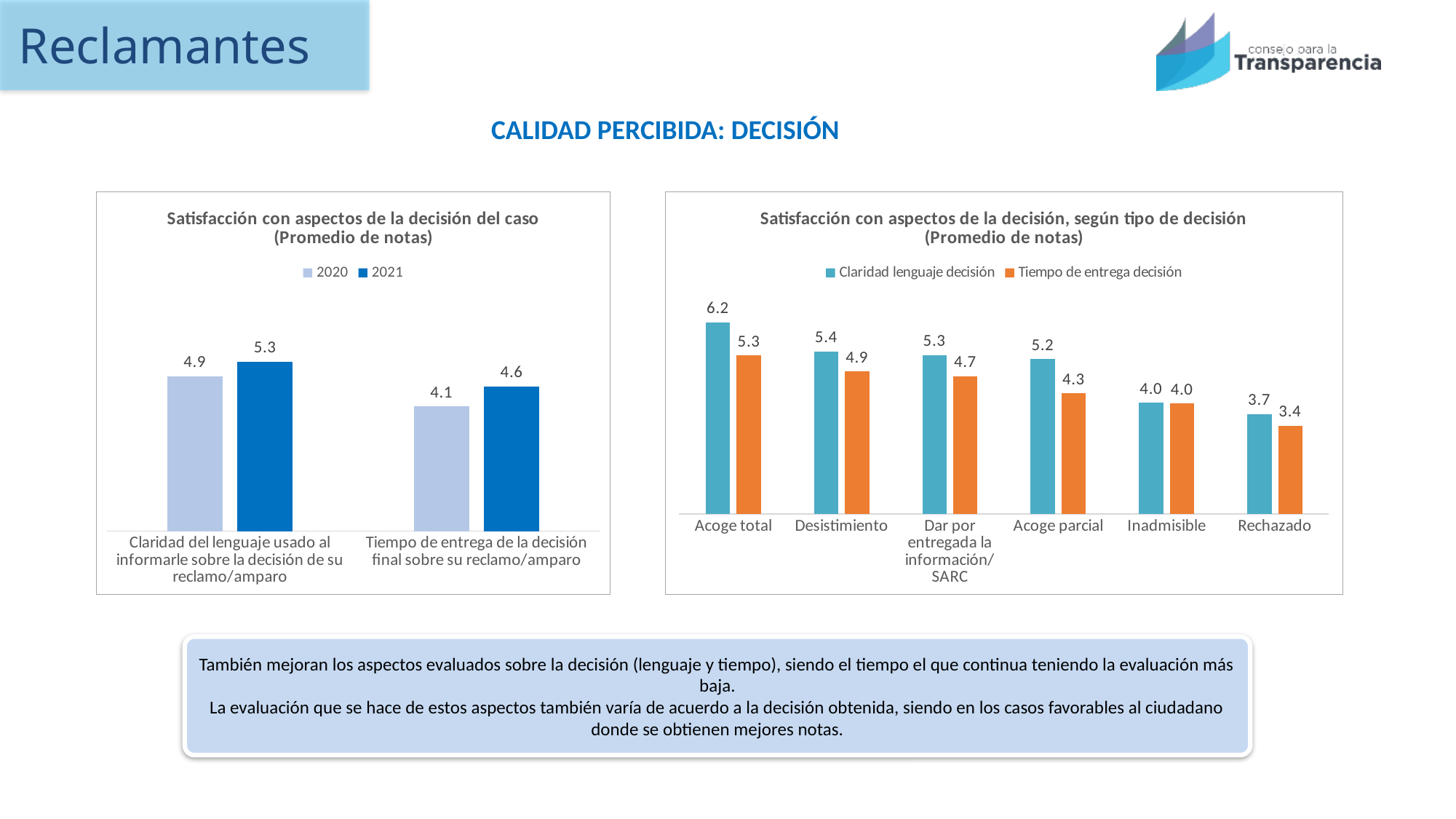
In the right chart (Satisfacción con aspectos de la decisión, según tipo de decisión), which decision type has the highest 'Claridad lenguaje decisión' value? Acoge total In the right chart (Satisfacción con aspectos de la decisión, según tipo de decisión), how many decision types are shown on the x axis? 6 In the left chart (Satisfacción con aspectos de la decisión del caso), what is the 2021 value for 'Claridad del lenguaje usado al informarle sobre la decisión de su reclamo/amparo'? 5.3 In the left chart (Satisfacción con aspectos de la decisión del caso), how many series does the legend list? 2 In the right chart (Satisfacción con aspectos de la decisión, según tipo de decisión), which decision type has the lowest 'Tiempo de entrega decisión' value? Rechazado In the left chart (Satisfacción con aspectos de la decisión del caso), by how much did the value for 'Tiempo de entrega de la decisión final sobre su reclamo/amparo' change from 2020 to 2021? 0.5 In the right chart (Satisfacción con aspectos de la decisión, según tipo de decisión), what is the 'Claridad lenguaje decisión' value for 'Acoge total'? 6.2 In the right chart (Satisfacción con aspectos de la decisión, según tipo de decisión), what is the difference between the 'Claridad lenguaje decisión' and 'Tiempo de entrega decisión' values for 'Acoge parcial'? 0.9 In the left chart (Satisfacción con aspectos de la decisión del caso), which year has the higher value for 'Claridad del lenguaje usado al informarle sobre la decisión de su reclamo/amparo'? 2021 What kind of chart is the right chart (Satisfacción con aspectos de la decisión, según tipo de decisión)? Bar chart In the right chart (Satisfacción con aspectos de la decisión, según tipo de decisión), what is the 'Tiempo de entrega decisión' value for 'Rechazado'? 3.4 In the left chart (Satisfacción con aspectos de la decisión del caso), what is the 2020 value for 'Tiempo de entrega de la decisión final sobre su reclamo/amparo'? 4.1